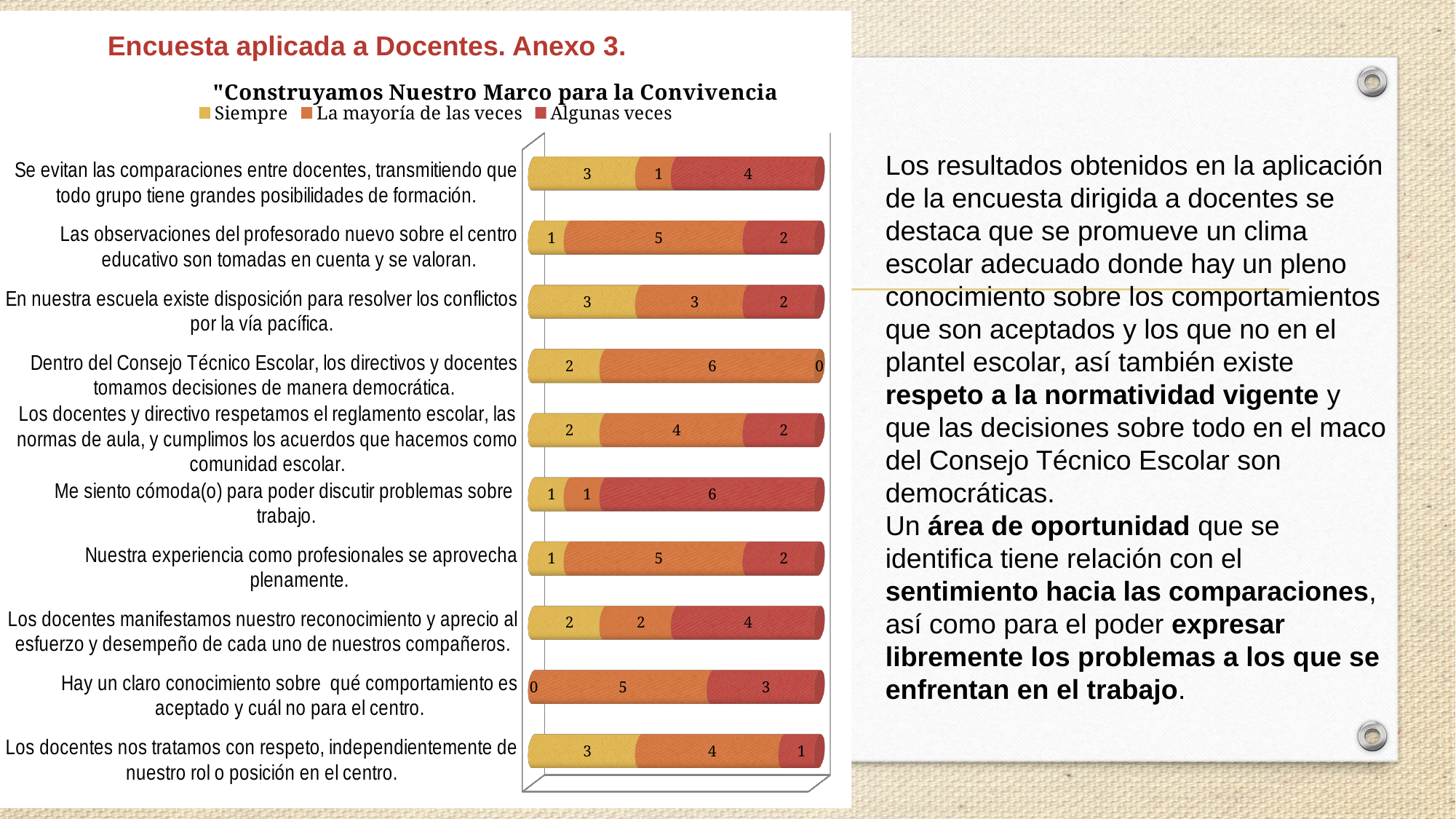
How many series does the chart legend list? 3 Which statement has the lowest value for "La mayoría de las veces"? Se evitan las comparaciones entre docentes, transmitiendo que todo grupo tiene grandes posibilidades de formación. and Me siento cómoda(o) para poder discutir problemas sobre trabajo. (both 1) What is the title of the chart? "Construyamos Nuestro Marco para la Convivencia How many categories (survey statements) are plotted in the chart? 10 What is the value of "La mayoría de las veces" for "Dentro del Consejo Técnico Escolar, los directivos y docentes tomamos decisiones de manera democrática."? 6 Which statement has the highest value for "Algunas veces"? Me siento cómoda(o) para poder discutir problemas sobre trabajo. What is the value of "Algunas veces" for "Me siento cómoda(o) para poder discutir problemas sobre trabajo."? 6 What is the value of "Siempre" for "Hay un claro conocimiento sobre qué comportamiento es aceptado y cuál no para el centro."? 0 What is the difference between the "La mayoría de las veces" value and the "Siempre" value for "Los docentes nos tratamos con respeto, independientemente de nuestro rol o posición en el centro."? 1 What is the total of the stacked bar for "En nuestra escuela existe disposición para resolver los conflictos por la vía pacífica."? 8 What kind of chart is shown on the slide? Stacked bar chart For "Se evitan las comparaciones entre docentes...", which is larger: the "Siempre" value or the "Algunas veces" value? Algunas veces